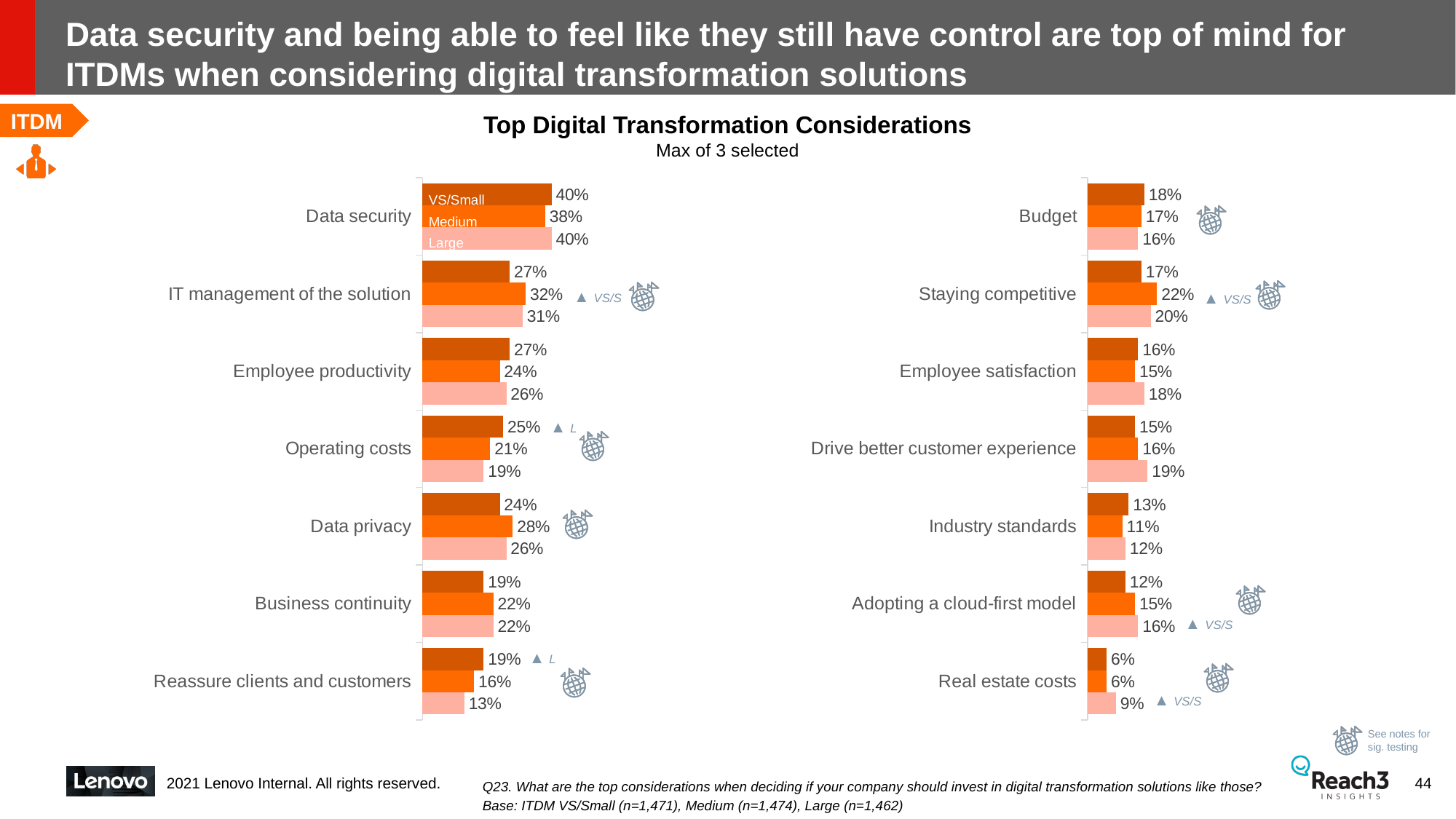
In the left chart, what is the VS/Small value for Operating costs? 25% How many categories are shown in the right chart? 7 In the right chart, which is larger for Employee satisfaction: the VS/Small value or the Large value? Large How many series (company sizes) are plotted for each category in the left chart? 3 In the left chart, what is the Medium value for IT management of the solution? 32% In the right chart, which category has the lowest Medium value? Real estate costs In the left chart, what is the difference between the VS/Small and Large values for Reassure clients and customers? 6% In the left chart, which category has the highest VS/Small value? Data security What type of chart is used on this slide? Bar chart In the right chart, what is the Medium value for Staying competitive? 22% What is the title shown above the charts? Top Digital Transformation Considerations In the right chart, what is the Large value for Real estate costs? 9%